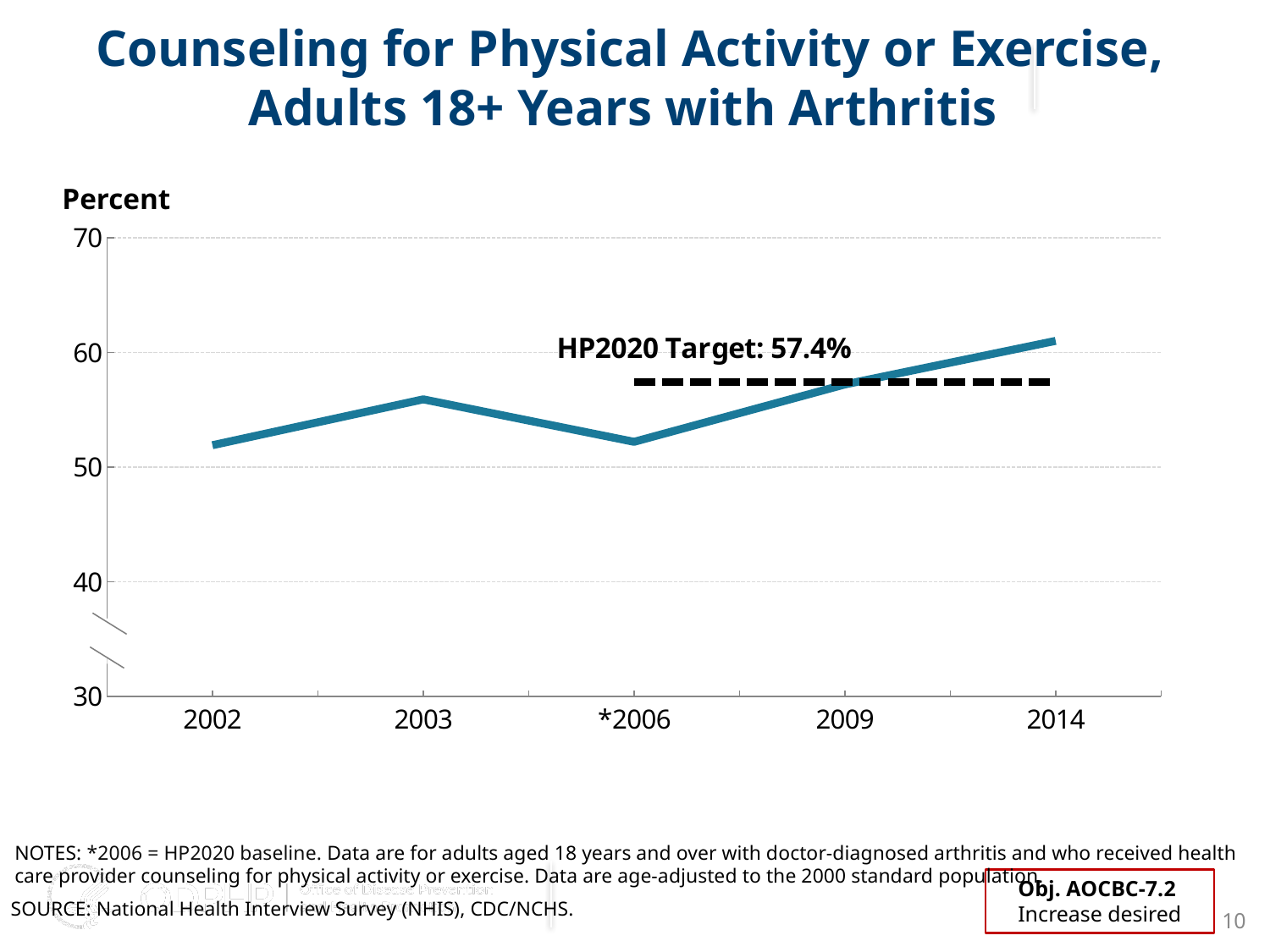
Is the value for 2003 greater or less than 50? greater Which year has the highest value on the chart? 2014 Is the value for 2014 greater or less than 50? greater How many data points are plotted on the line? 5 Which year has the larger value, 2002 or 2014? 2014 Is the value for 2009 greater or less than 60? less What kind of chart is shown on the slide? line chart Which year has the larger value, 2003 or 2006? 2003 Which year is marked with an asterisk as the HP2020 baseline? 2006 Do the values rise or fall from 2006 to 2014? rise What is the HP2020 target value shown on the chart? 57.4%